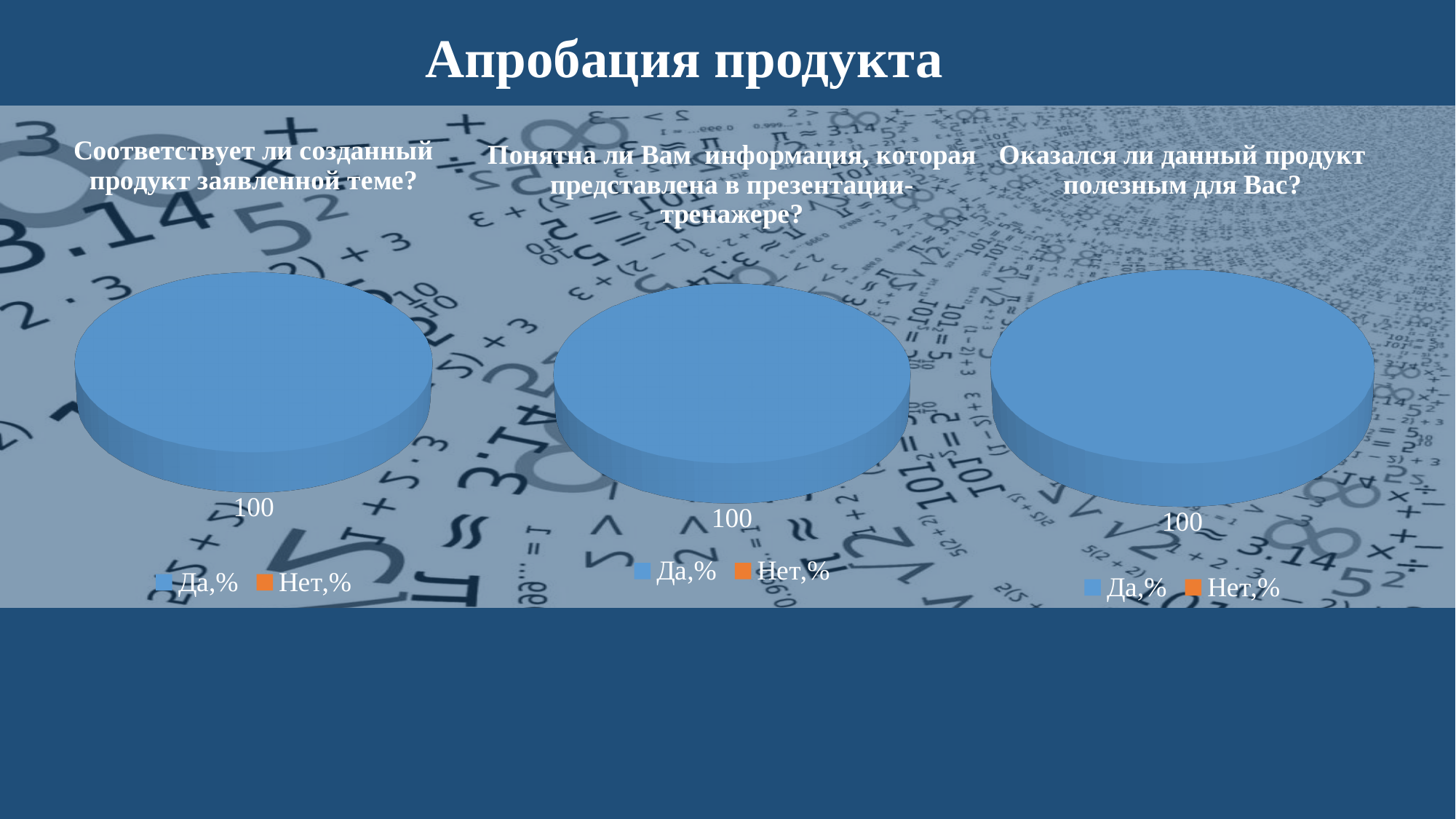
What kind of chart is the left chart titled "Соответствует ли созданный продукт заявленной теме?"? pie chart In the middle chart "Понятна ли Вам информация, которая представлена в презентации-тренажере?", which category takes up the whole pie? Да,% In the left chart "Соответствует ли созданный продукт заявленной теме?", what value is shown for Да,%? 100 In the right chart "Оказался ли данный продукт полезным для Вас?", which category is larger, Да,% or Нет,%? Да,% In the middle chart "Понятна ли Вам информация, которая представлена в презентации-тренажере?", what value is shown for Да,%? 100 In the right chart "Оказался ли данный продукт полезным для Вас?", what value is shown for Да,%? 100 How many pie charts are shown on the slide? 3 What are the two legend entries of the middle chart "Понятна ли Вам информация, которая представлена в презентации-тренажере?"? Да,% and Нет,% How many entries does the legend of the right chart "Оказался ли данный продукт полезным для Вас?" list? 2 In the left chart "Соответствует ли созданный продукт заявленной теме?", what share of the pie does Да,% take? 100% What colour is the Да,% slice in the right chart "Оказался ли данный продукт полезным для Вас?"? blue How many entries does the legend of the left chart "Соответствует ли созданный продукт заявленной теме?" list? 2